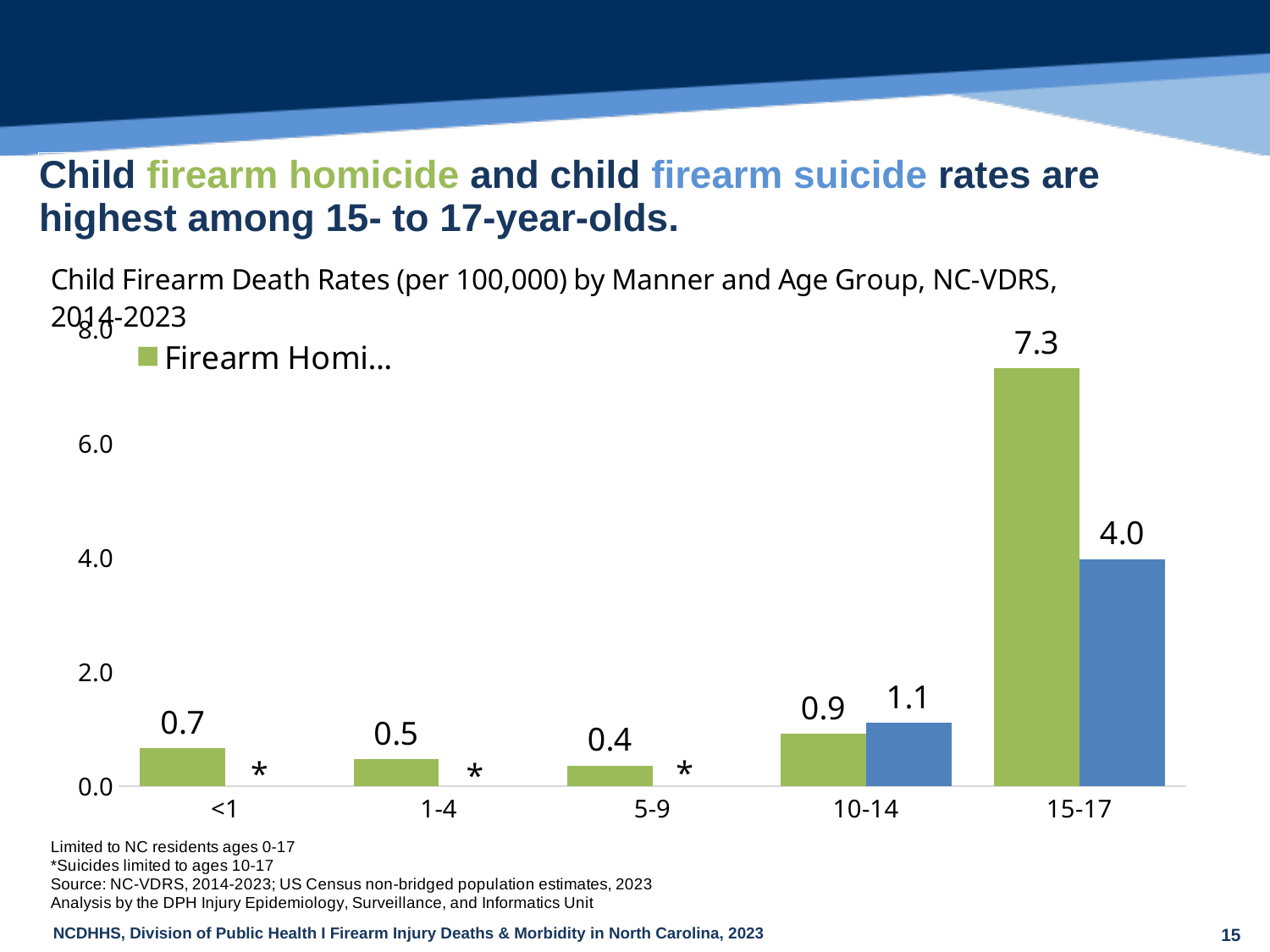
What is the firearm homicide rate (green bar) for the <1 age group? 0.7 What is the difference between the green bar and the blue bar for the 15-17 age group? 3.3 What is the value of the blue bar for the 10-14 age group? 1.1 What is the value of the blue bar for the 15-17 age group? 4.0 How many age groups are shown on the x axis? 5 Is the firearm homicide rate (green bar) for the 15-17 age group greater or less than 6.0? greater What is the firearm homicide rate (green bar) for the 15-17 age group? 7.3 What does the asterisk (*) shown for the <1, 1-4 and 5-9 age groups indicate, according to the footnote? Suicides limited to ages 10-17 Which age group has the highest firearm homicide rate (green bar)? 15-17 For the 10-14 age group, which is larger: the green bar or the blue bar? the blue bar Which age group has the lowest firearm homicide rate (green bar)? 5-9 What type of chart is shown on the slide? bar chart